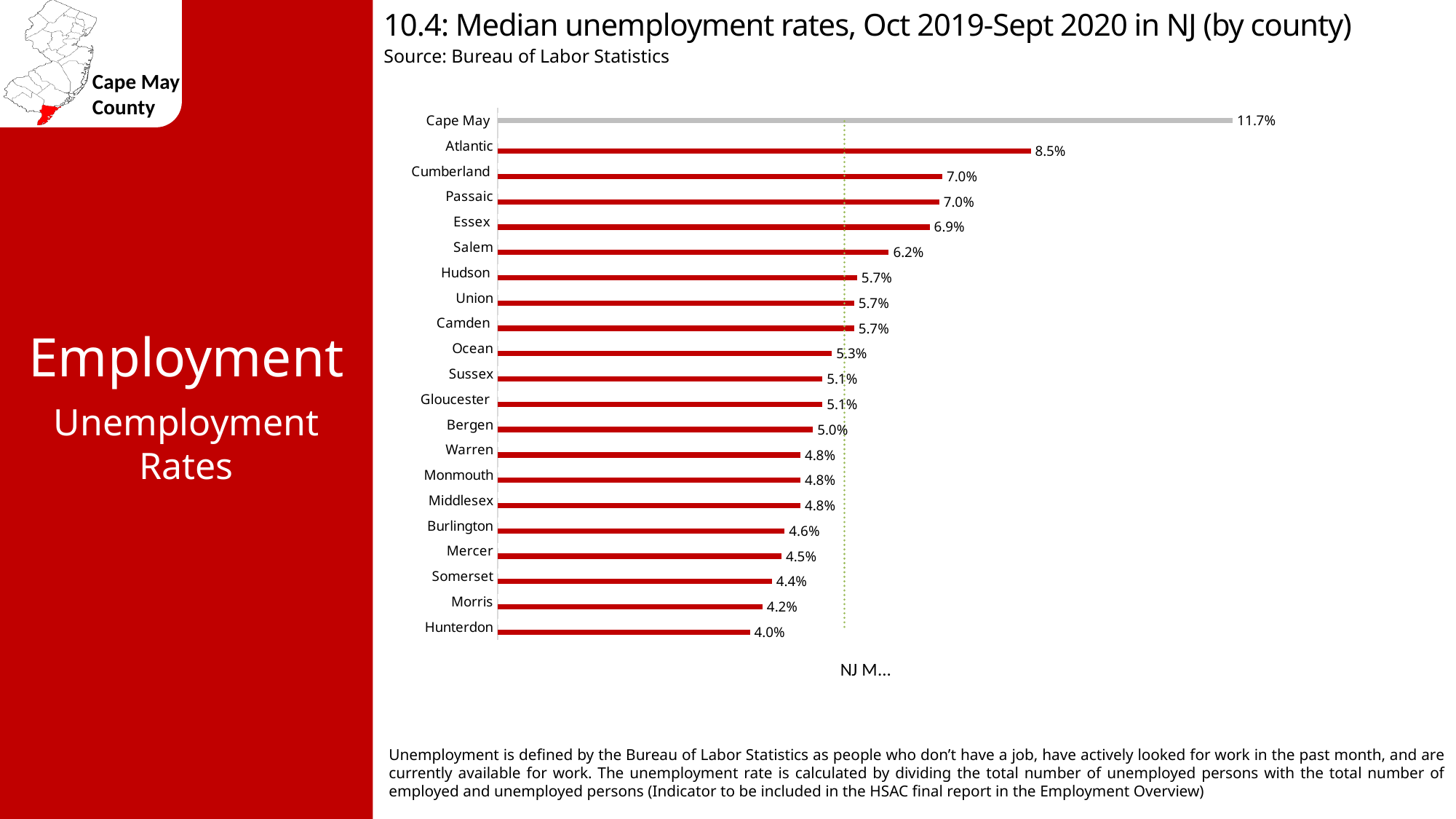
How many counties are shown in the chart? 21 What kind of chart is used to show the median unemployment rates? Bar chart Which county has a higher median unemployment rate, Ocean or Bergen? Ocean What is the difference between the median unemployment rates of Cape May and Atlantic? 3.2% Which county has the lowest median unemployment rate? Hunterdon Which county has the highest median unemployment rate? Cape May What is the difference between the median unemployment rates of Essex and Hunterdon? 2.9% What is the median unemployment rate for Atlantic? 8.5% What is the median unemployment rate for Cape May? 11.7% Which county's bar is coloured grey instead of red? Cape May What is the median unemployment rate for Hunterdon? 4.0% What is the median unemployment rate for Salem? 6.2%